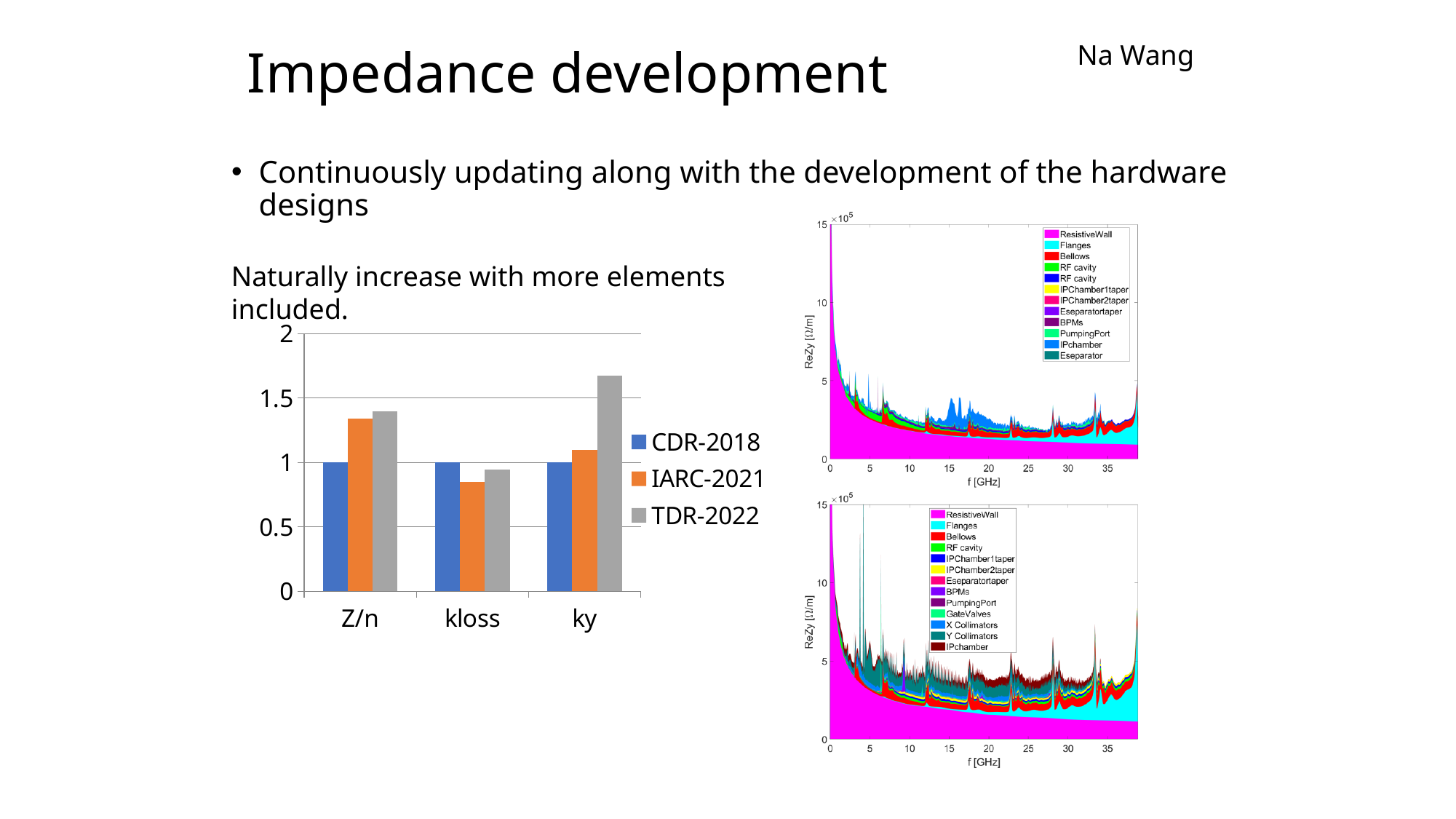
On the bar chart, is the value of IARC-2021 for kloss greater or less than 1? less On the bar chart, is the value of TDR-2022 for ky greater or less than 1.5? greater On the bar chart, which series has the highest value for ky? TDR-2022 On the bar chart, how many categories are shown on the x axis? 3 On the bar chart, what is the value of CDR-2018 for Z/n? 1 On the bar chart, which category has the highest TDR-2022 value? ky On the bar chart, which series has the lowest value for kloss? IARC-2021 On the bar chart, what is the value of CDR-2018 for ky? 1 On the bar chart, is the value of IARC-2021 for Z/n greater or less than 1? greater On the bar chart, how many series does the legend list? 3 In the top-right chart, how many entries does the legend list? 12 What kind of chart is the chart on the left of the slide? bar chart